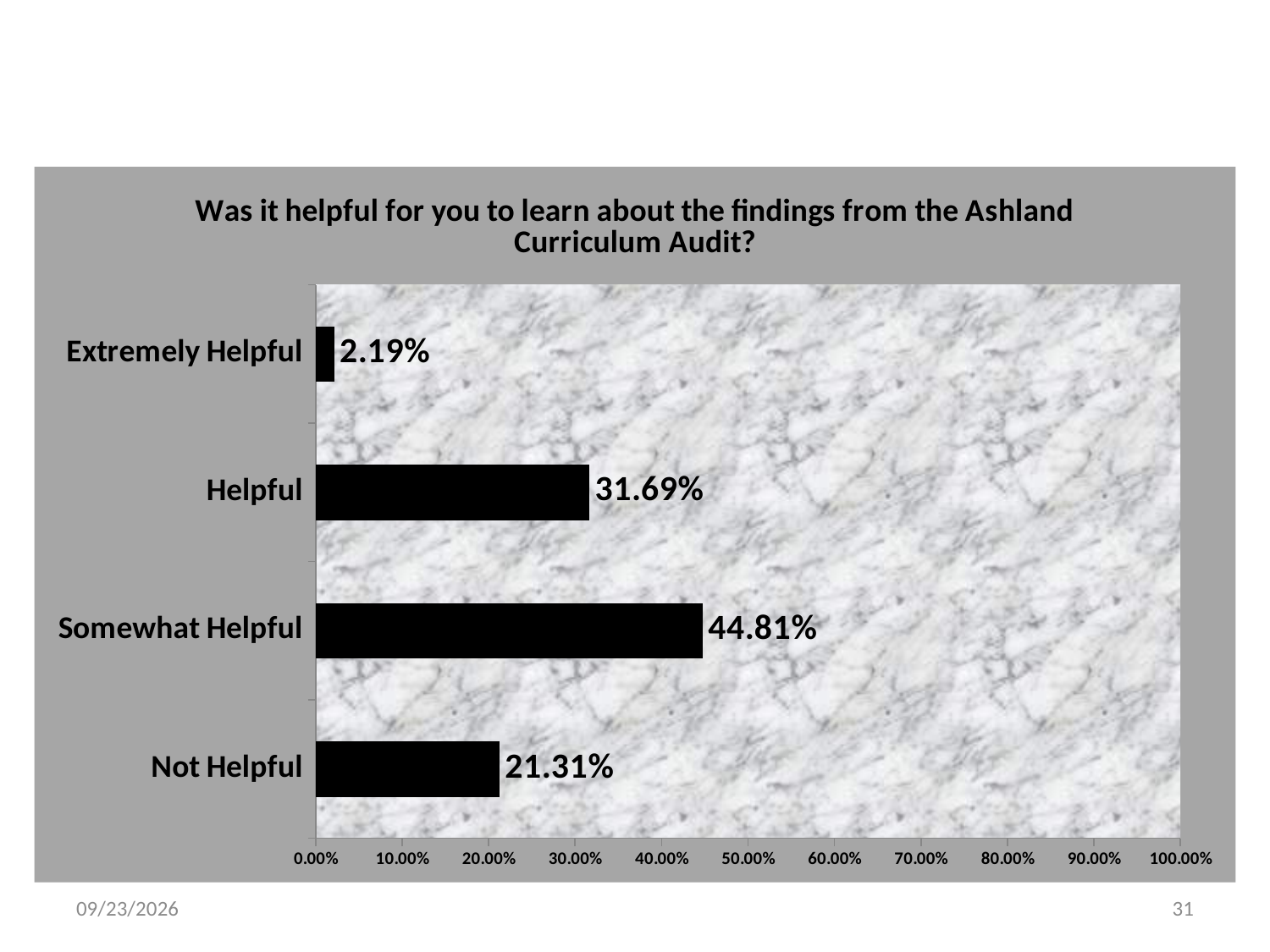
What kind of chart is shown on the slide? Bar chart What is the value for Helpful? 31.69% What is the difference between the values for Helpful and Not Helpful? 10.38% What is the difference between the values for Somewhat Helpful and Helpful? 13.12% What is the value for Somewhat Helpful? 44.81% Is the value for Somewhat Helpful greater or less than 40.00%? greater How many categories are shown in the chart? 4 What is the value for Extremely Helpful? 2.19% Which category has the lowest value? Extremely Helpful Which is larger, the value for Helpful or the value for Not Helpful? Helpful What is the value for Not Helpful? 21.31% Which category has the highest value? Somewhat Helpful